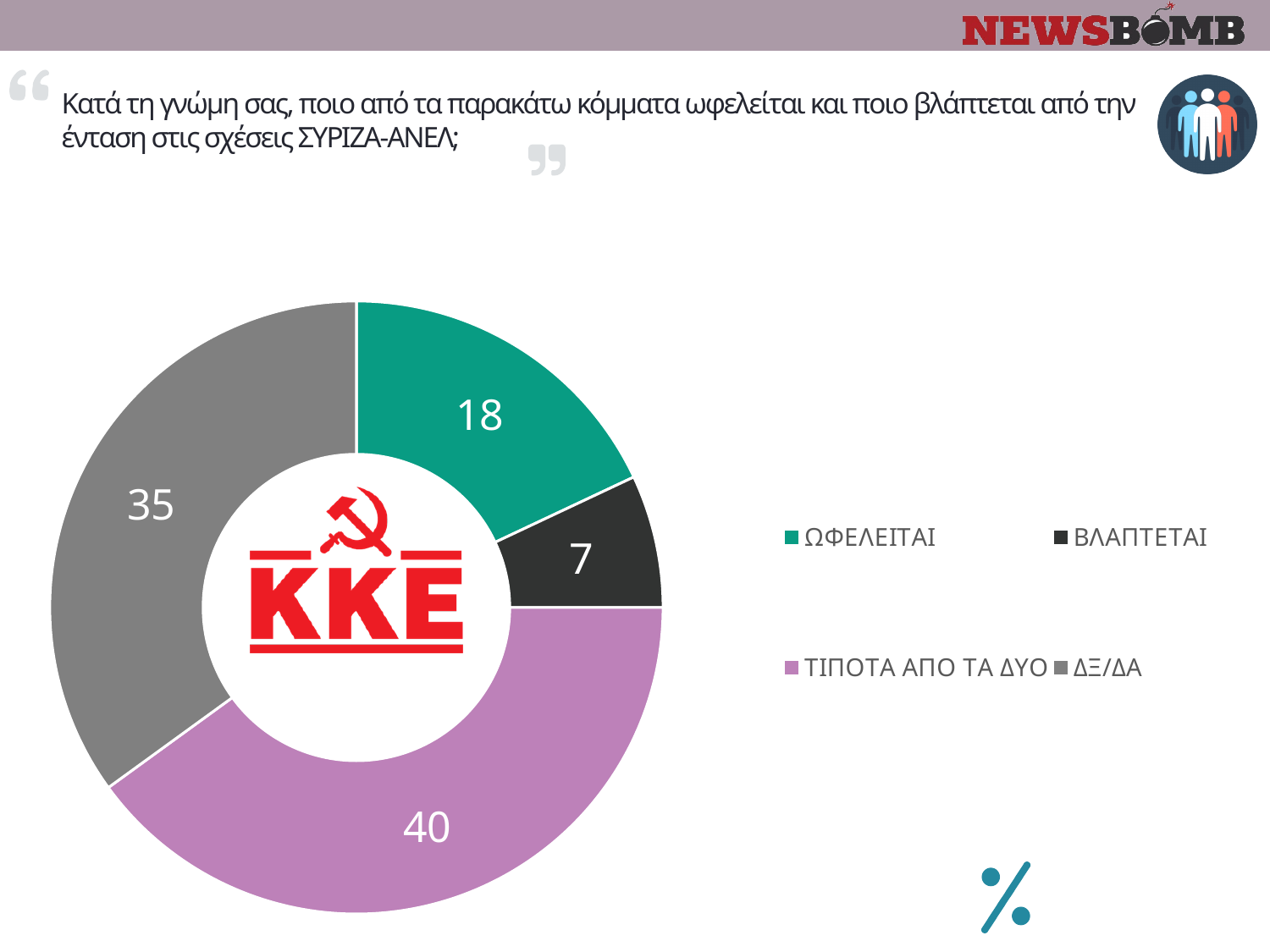
What value is shown for the ΒΛΑΠΤΕΤΑΙ slice? 7 What value is shown for the ΤΙΠΟΤΑ ΑΠΟ ΤΑ ΔΥΟ slice? 40 Which category has the smallest slice? ΒΛΑΠΤΕΤΑΙ What value is shown for the ΔΞ/ΔΑ slice? 35 Which party logo appears in the centre of the chart? KKE What value is shown for the ΩΦΕΛΕΙΤΑΙ slice? 18 What is the difference between the ΤΙΠΟΤΑ ΑΠΟ ΤΑ ΔΥΟ value and the ΔΞ/ΔΑ value? 5 What is the difference between the ΩΦΕΛΕΙΤΑΙ value and the ΒΛΑΠΤΕΤΑΙ value? 11 How many slices does the chart have? 4 Which is larger, the ΩΦΕΛΕΙΤΑΙ value or the ΔΞ/ΔΑ value? ΔΞ/ΔΑ Which category has the largest slice? ΤΙΠΟΤΑ ΑΠΟ ΤΑ ΔΥΟ What kind of chart is shown on the slide? Doughnut (pie) chart